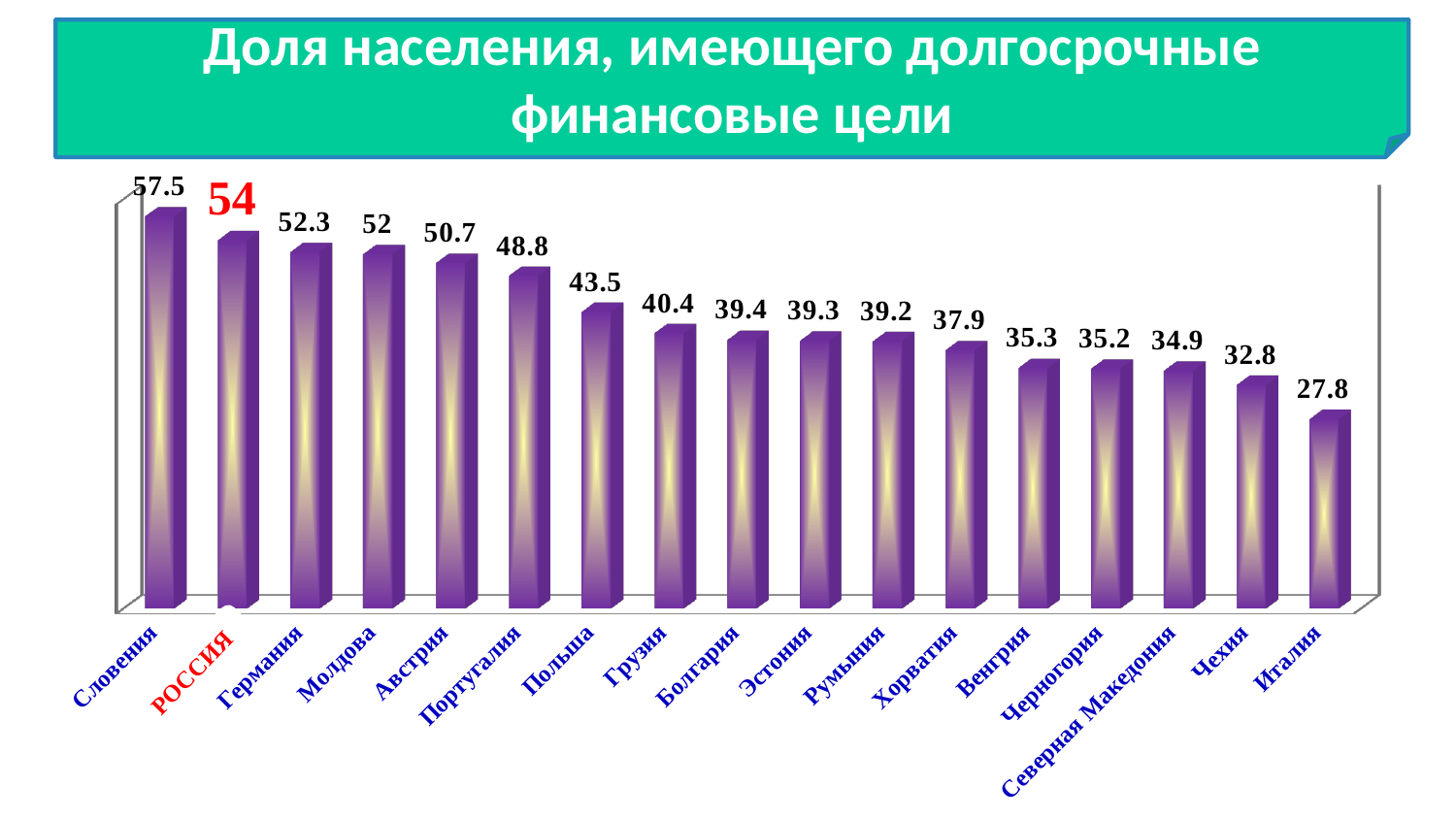
What is the difference between the values for Словения and РОССИЯ? 3.5 Which country has the highest value? Словения Do the values rise or fall from left to right along the x axis? Fall What is the value for РОССИЯ? 54 What is the value for Португалия? 48.8 What kind of chart is shown on the slide? Bar chart How many countries are shown in the chart? 17 What is the difference between the values for Польша and Италия? 15.7 Which country has the lowest value? Италия Which has a larger value, Германия or Грузия? Германия What is the title of the chart? Доля населения, имеющего долгосрочные финансовые цели What is the value for Северная Македония? 34.9